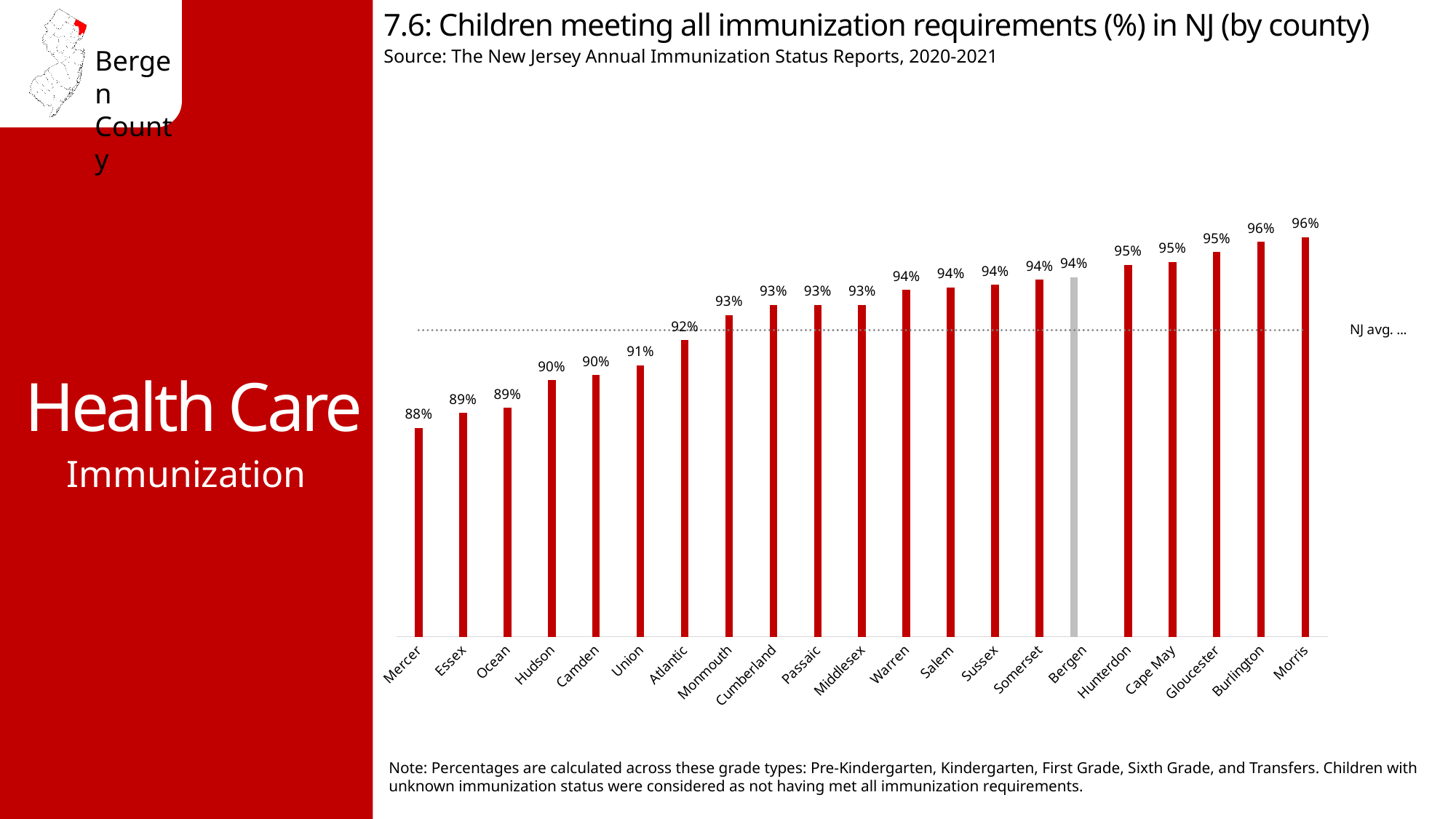
Which is larger, the value for Atlantic or the value for Union? Atlantic How many counties are shown in the chart? 21 Which county's bar is coloured grey instead of red? Bergen What is the value for Hunterdon? 95% What is the value for Atlantic? 92% Do the values rise or fall from left to right along the x axis? Rise What is the difference between the values for Morris and Mercer? 8 percentage points What is the value for Morris? 96% Which county has the lowest percentage of children meeting all immunization requirements? Mercer What is the value for Mercer? 88% What kind of chart is shown on the slide? Bar chart What is the value for Bergen? 94%